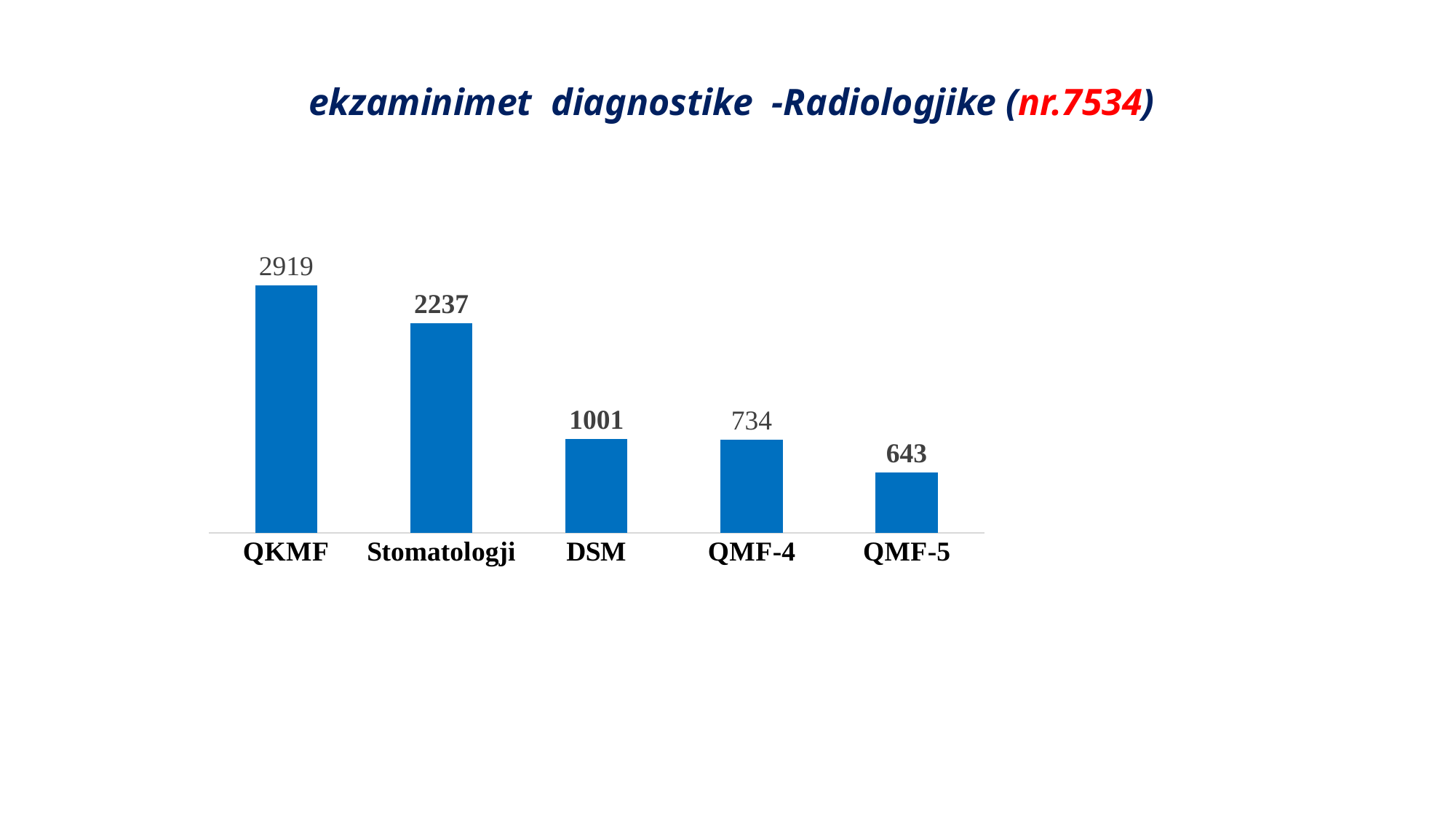
Which category has the lowest value? QMF-5 Which category has the highest value? QKMF What is the value for QKMF? 2919 What is the difference between the values for QKMF and Stomatologji? 682 What is the value for QMF-4? 734 Which is larger, the value for QMF-4 or the value for QMF-5? QMF-4 How many categories are shown in the chart? 5 What is the value for DSM? 1001 What is the value for Stomatologji? 2237 What is the difference between the values for DSM and QMF-5? 358 What is the value for QMF-5? 643 What kind of chart is shown on the slide? Bar chart